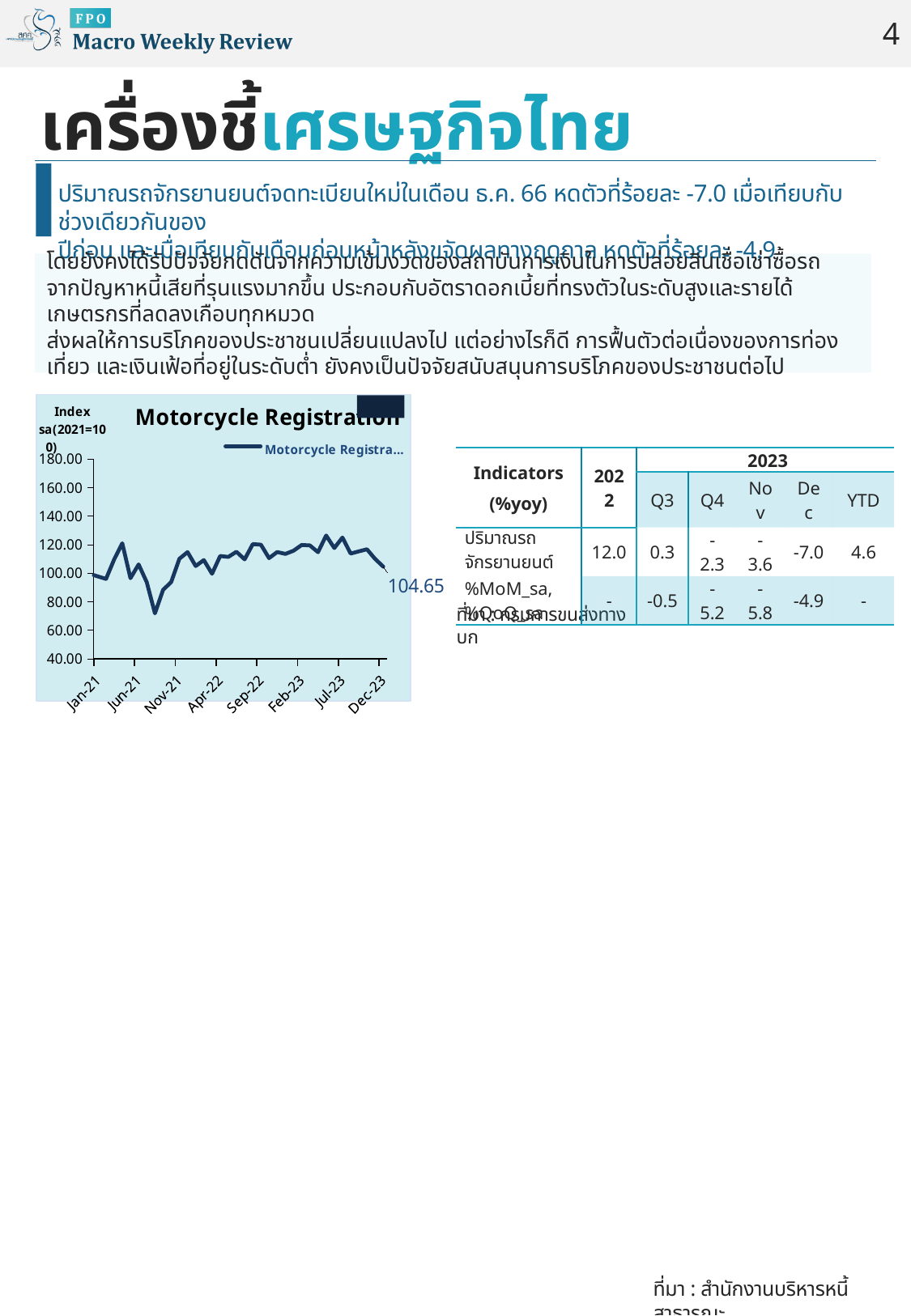
Is the Motorcycle Registration index value at Dec-23 greater or less than 100? greater What is the title of the line chart on the slide? Motorcycle Registration Is the lowest point on the Motorcycle Registration line greater or less than 80? less Is the highest point on the Motorcycle Registration line greater or less than 140? less What kind of chart is the Motorcycle Registration chart? line chart Between Jul-23 and Dec-23, does the Motorcycle Registration line rise or fall? fall What is the highest tick value shown on the y axis of the Motorcycle Registration chart? 180.00 What is the value of the Motorcycle Registration index at Dec-23, as printed on the chart? 104.65 How many date labels are shown on the x axis of the Motorcycle Registration chart? 8 How many series does the legend of the Motorcycle Registration chart list? 1